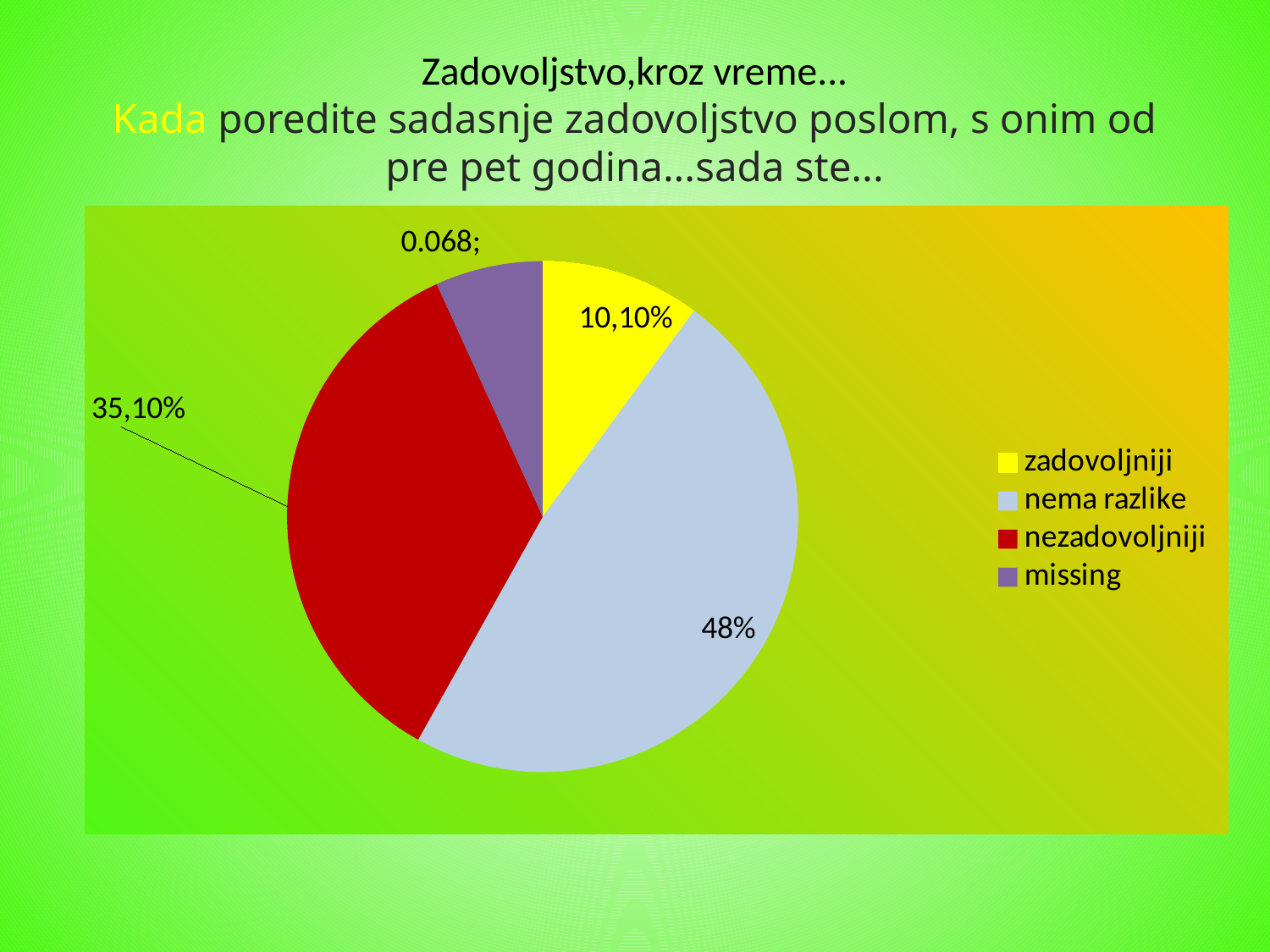
Which category has the smallest slice of the pie? missing Which slice is larger, 'nezadovoljniji' or 'zadovoljniji'? nezadovoljniji Which category has the largest slice of the pie? nema razlike What percentage is shown for the 'nema razlike' slice? 48% What colour is the 'missing' slice? purple What percentage is shown for the 'zadovoljniji' slice? 10,10% What is the difference between the 'nezadovoljniji' and 'zadovoljniji' percentages? 25% What is the difference between the 'nema razlike' and 'nezadovoljniji' percentages? 12,90% What percentage is shown for the 'nezadovoljniji' slice? 35,10% What colour is the 'nezadovoljniji' slice? red What kind of chart is shown on the slide? pie chart How many categories does the legend list? 4